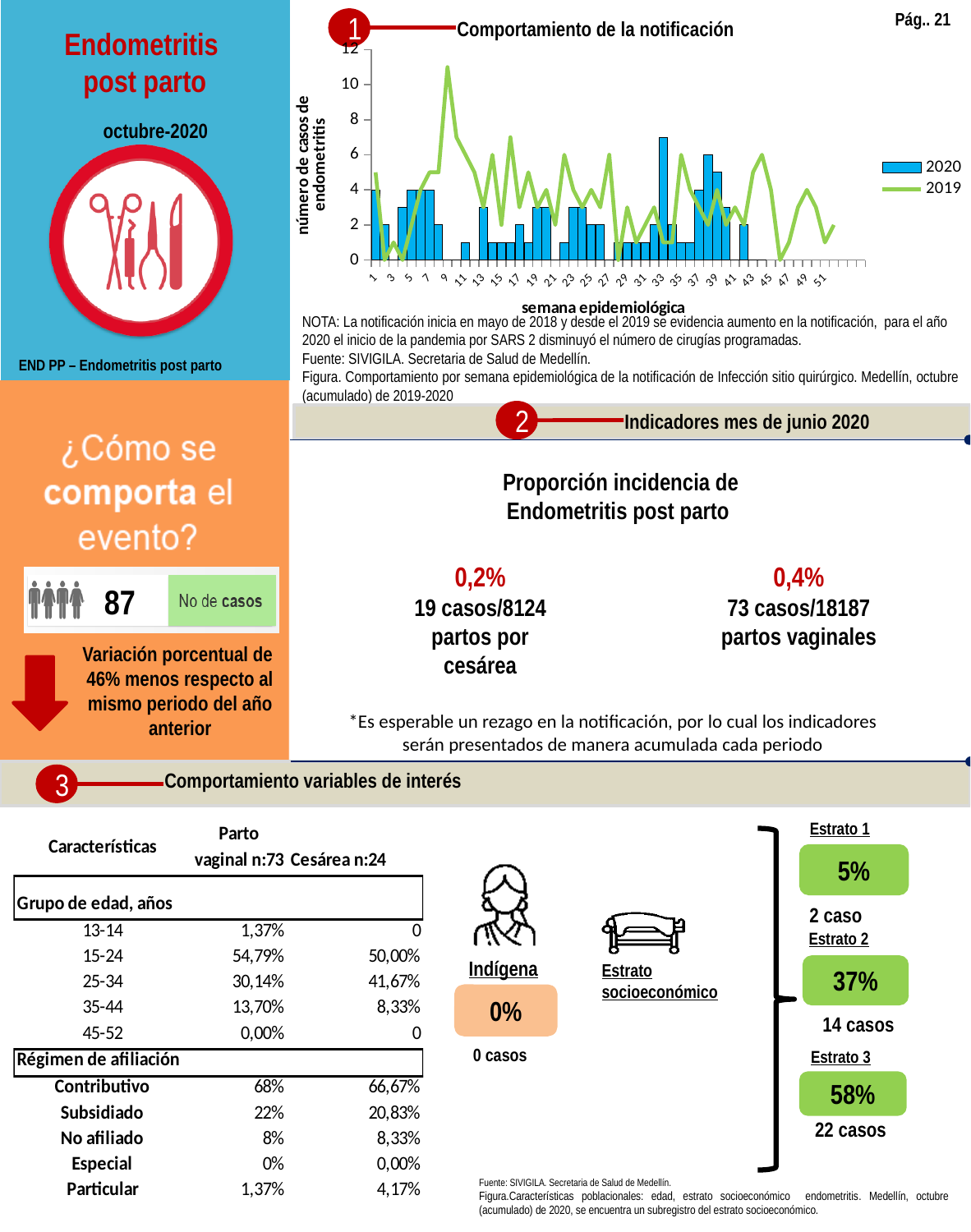
In the 'Comportamiento de la notificación' chart, is the 2020 value at week 11 greater or less than 2? less In the 'Comportamiento de la notificación' chart, is the 2019 value at week 9 greater or less than 10? greater In the 'Comportamiento de la notificación' chart, is the 2020 value at week 33 greater or less than 6? greater In the 'Comportamiento de la notificación' chart, how many cases does the 2020 bar at week 37 show? 4 In the 'Comportamiento de la notificación' chart, what is the highest value shown on the vertical axis? 12 Which two series are listed in the legend of the 'Comportamiento de la notificación' chart? 2020 and 2019 In the 'Comportamiento de la notificación' chart, at which epidemiological week does the 2019 line reach its highest value? Week 9 How many series does the legend of the 'Comportamiento de la notificación' chart list? 2 What kind of chart is shown under 'Comportamiento de la notificación'? A bar chart with a line series What is the title of the vertical axis of the 'Comportamiento de la notificación' chart? número de casos de endometritis In the 'Comportamiento de la notificación' chart, which is larger: the 2019 peak at week 9 or the 2020 peak at week 33? The 2019 peak at week 9 In the 'Comportamiento de la notificación' chart, at which epidemiological week is the 2020 bar the tallest? Week 33